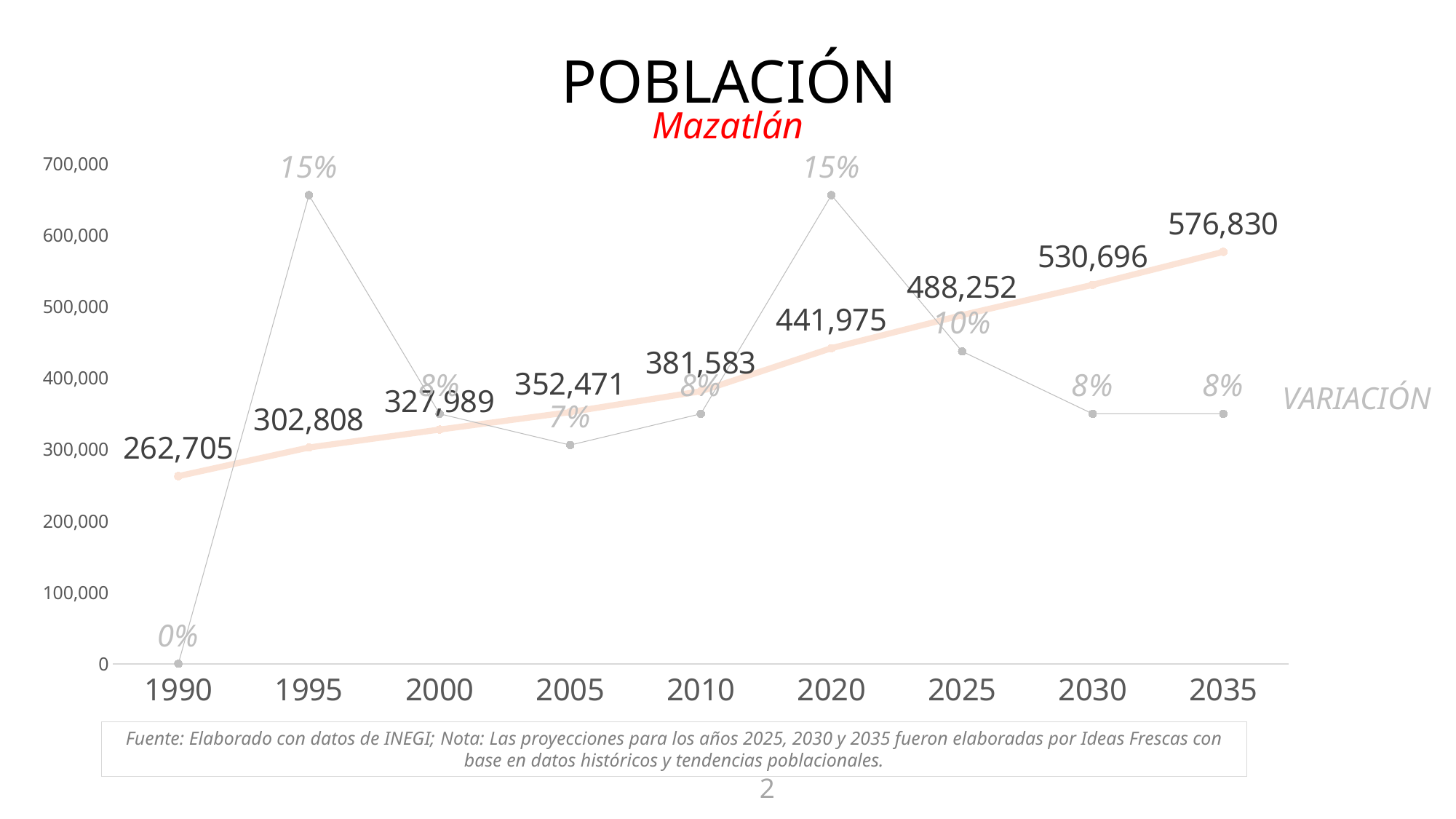
Which year has the lowest population value? 1990 How many years are plotted on the x axis? 9 Which is larger, the population value for 2005 or for 2010? 2010 What variation percentage is shown for 2025? 10% What is the population value shown for 1990? 262,705 What is the population value shown for 2020? 441,975 What is the subtitle shown in red under the chart title? Mazatlán Which year has the highest population value? 2035 What is the population value shown for 2035? 576,830 Does the population line rise or fall from 1990 to 2035? Rises What is the difference between the population values for 2035 and 2030? 46,134 What kind of chart is shown on the slide? Line chart